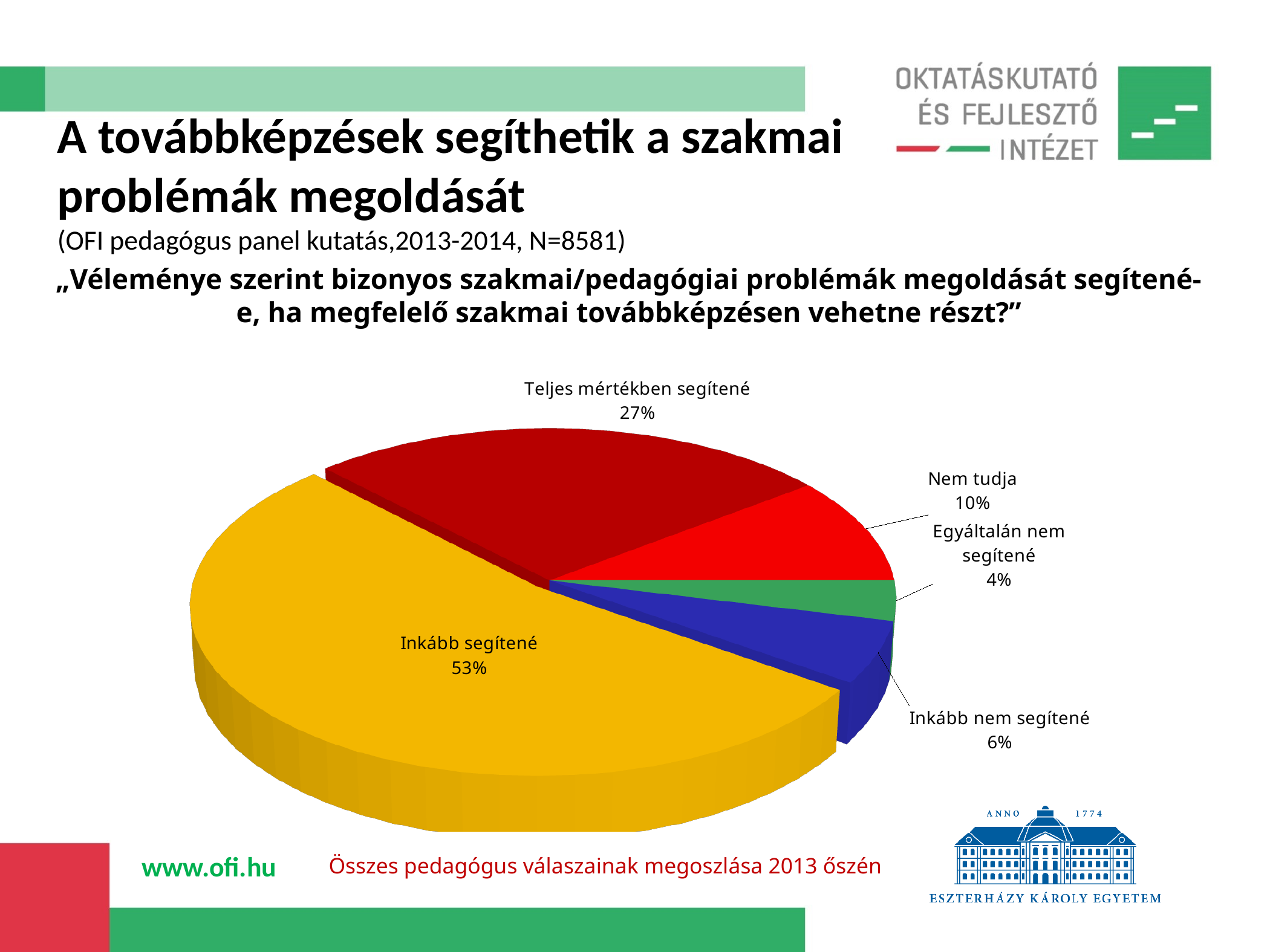
Which response category has the smallest slice of the pie? Egyáltalán nem segítené What share of respondents answered "Inkább segítené"? 53% What share of respondents answered "Inkább nem segítené"? 6% What share of respondents answered "Teljes mértékben segítené"? 27% Which response category has the largest slice of the pie? Inkább segítené How many response categories are shown in the pie chart? 5 What share of respondents answered "Nem tudja"? 10% What is the difference in percentage points between "Inkább segítené" and "Teljes mértékben segítené"? 26 What colour is the slice for "Inkább segítené"? Yellow What share of respondents answered "Egyáltalán nem segítené"? 4% Which is larger: the share for "Nem tudja" or the share for "Inkább nem segítené"? Nem tudja What kind of chart is shown on the slide? Pie chart